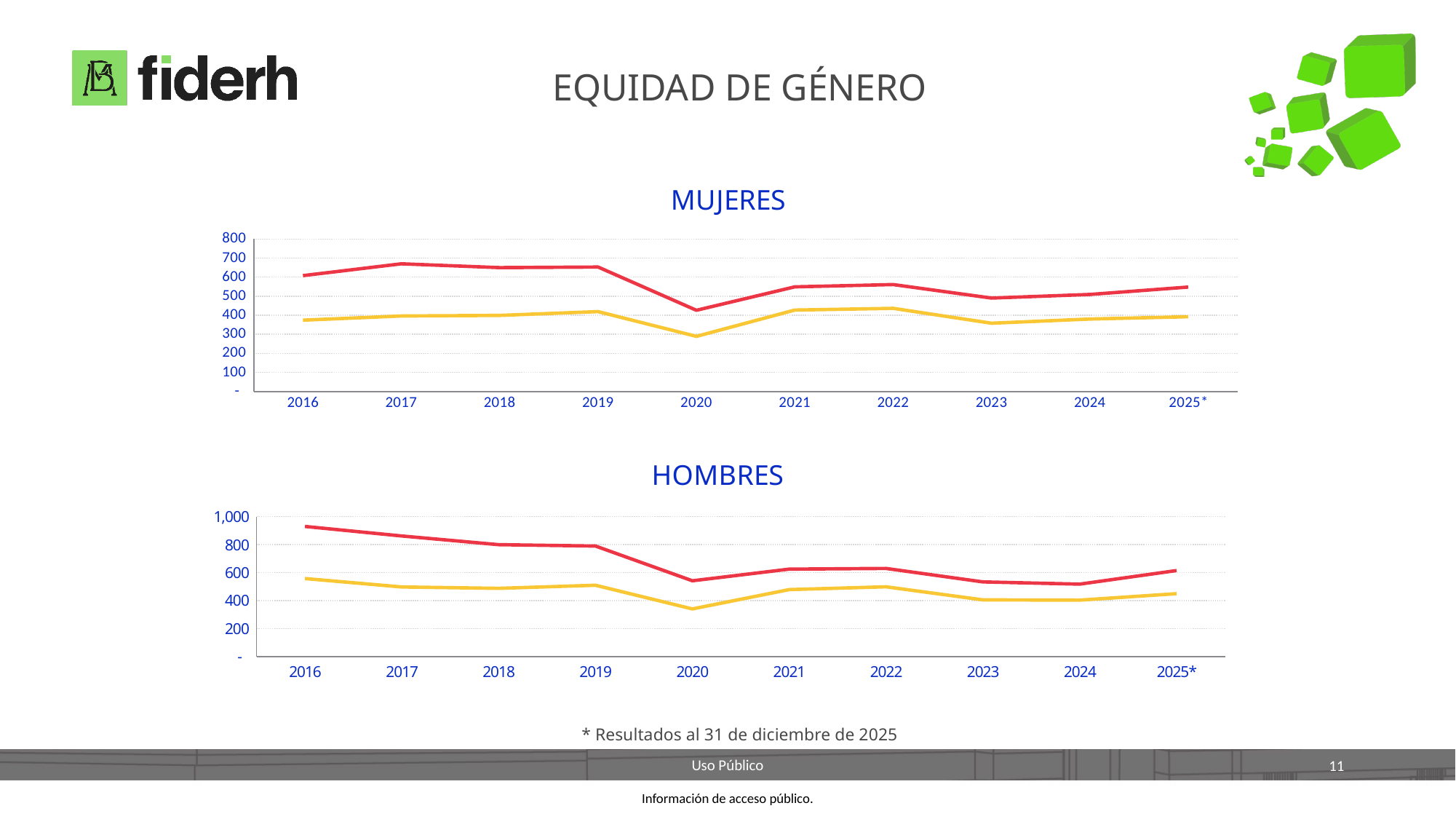
How many years are shown on the x axis of the HOMBRES chart? 10 In the HOMBRES chart, is the value of the yellow line in 2020 greater or less than 400? less In the HOMBRES chart, does the red line rise or fall from 2016 to 2019? fall In the HOMBRES chart, is the value of the red line in 2016 greater or less than 800? greater What kind of chart is the MUJERES chart? line chart In the HOMBRES chart, in which year does the red line reach its highest point? 2016 What are the titles of the two charts on the slide? MUJERES and HOMBRES In the MUJERES chart, is the value of the red line in 2017 greater or less than 600? greater In the HOMBRES chart, which line is higher in 2025*, the red line or the yellow line? the red line In the HOMBRES chart, in which year does the yellow line reach its lowest point? 2020 In the MUJERES chart, in which year does the red line reach its lowest point? 2020